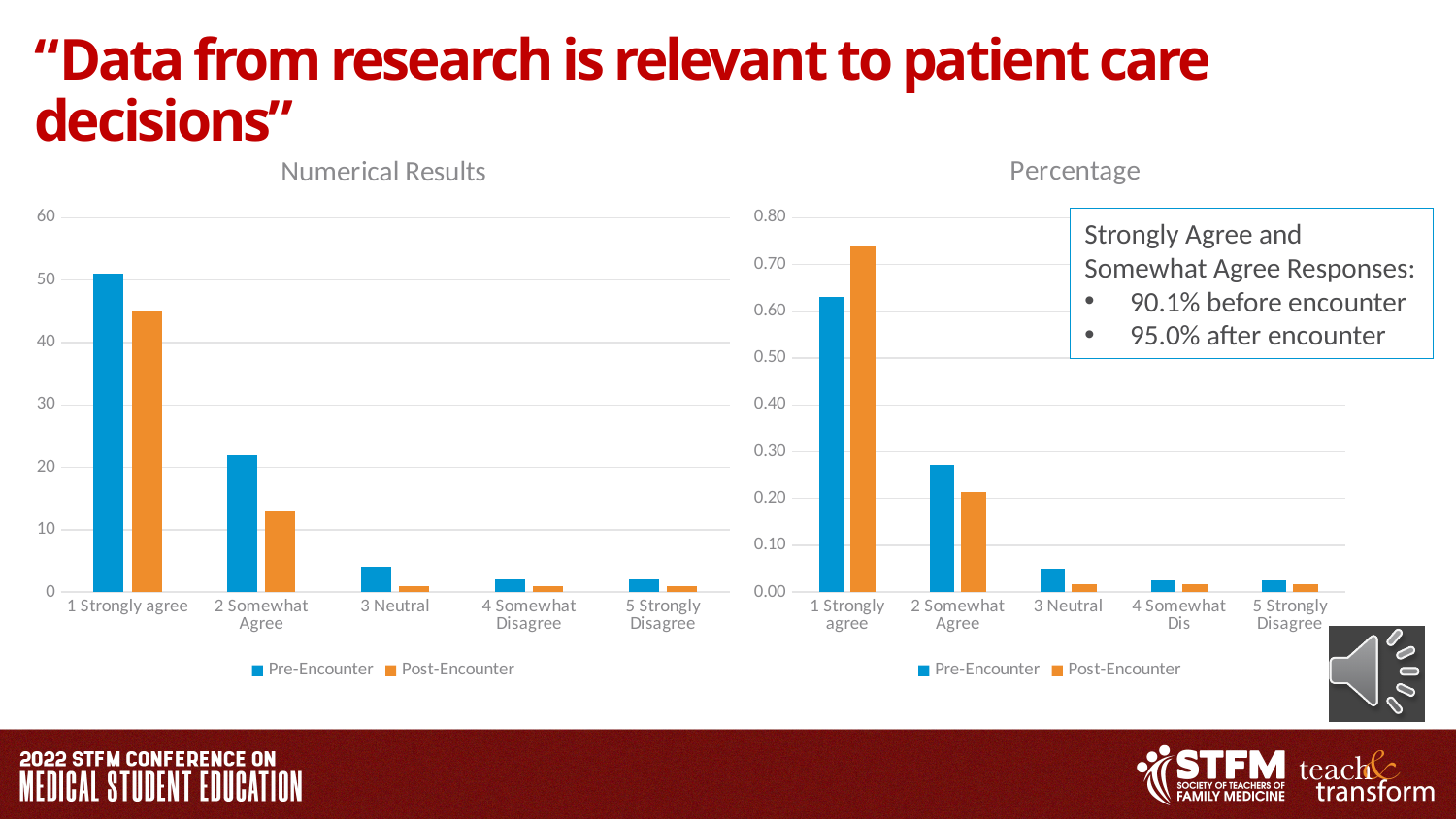
In the Numerical Results chart, is the Pre-Encounter value for 1 Strongly agree greater or less than 40? greater In the Percentage chart, is the Pre-Encounter value for 2 Somewhat Agree greater or less than 0.30? less In the Percentage chart, for 1 Strongly agree, which is larger: the Pre-Encounter or the Post-Encounter value? Post-Encounter What kind of chart is the Numerical Results chart? bar chart In the Numerical Results chart, which category has the highest Pre-Encounter value? 1 Strongly agree In the Numerical Results chart, is the Post-Encounter value for 2 Somewhat Agree greater or less than 20? less In the Percentage chart, what colour represents the Post-Encounter series? orange How many series does the legend of the Percentage chart list? 2 How many response categories are shown on the x axis of the Numerical Results chart? 5 In the Numerical Results chart, do the Pre-Encounter values generally rise or fall from 1 Strongly agree to 5 Strongly Disagree? fall In the Numerical Results chart, for 1 Strongly agree, which is larger: the Pre-Encounter or the Post-Encounter value? Pre-Encounter